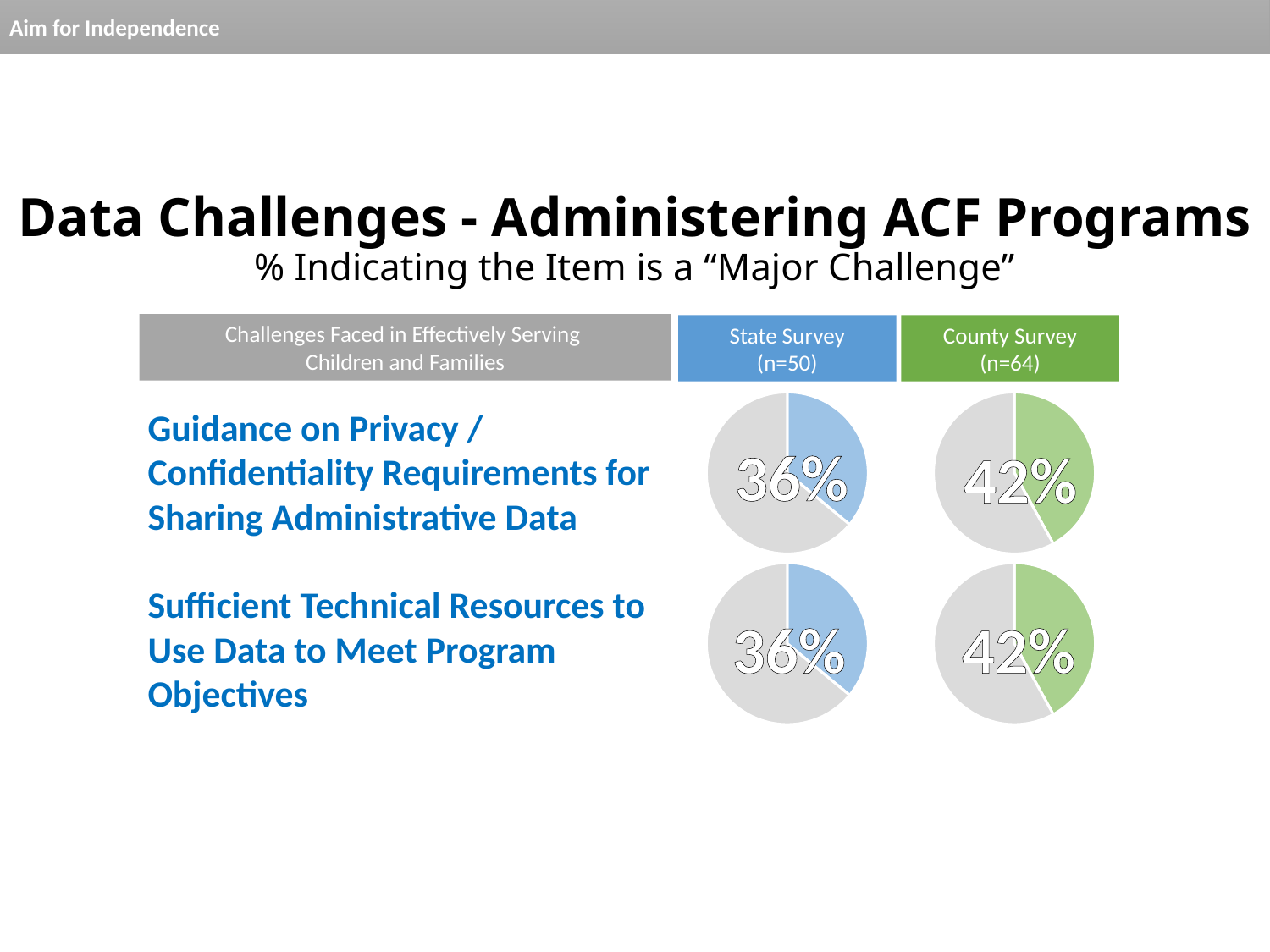
What is the sample size (n) shown for the State Survey column? n=50 In the pie chart for 'Sufficient Technical Resources to Use Data to Meet Program Objectives' under the State Survey column, what percentage is shown? 36% For the 'Guidance on Privacy / Confidentiality Requirements for Sharing Administrative Data' row, which survey shows the higher percentage, State Survey or County Survey? County Survey In the County Survey pie chart for 'Sufficient Technical Resources to Use Data to Meet Program Objectives', is the coloured slice greater or less than 50%? less For the 'Guidance on Privacy / Confidentiality Requirements for Sharing Administrative Data' row, what is the difference between the County Survey and State Survey percentages? 6% What is the sample size (n) shown for the County Survey column? n=64 For the 'Sufficient Technical Resources to Use Data to Meet Program Objectives' row, what is the difference between the County Survey and State Survey percentages? 6% What kind of chart is used to display the percentages on this slide? Pie chart In the pie chart for 'Guidance on Privacy / Confidentiality Requirements for Sharing Administrative Data' under the State Survey column, what percentage is shown? 36% How many pie charts are shown on the slide? 4 In the pie chart for 'Sufficient Technical Resources to Use Data to Meet Program Objectives' under the County Survey column, what percentage is shown? 42% In the pie chart for 'Guidance on Privacy / Confidentiality Requirements for Sharing Administrative Data' under the County Survey column, what percentage is shown? 42%